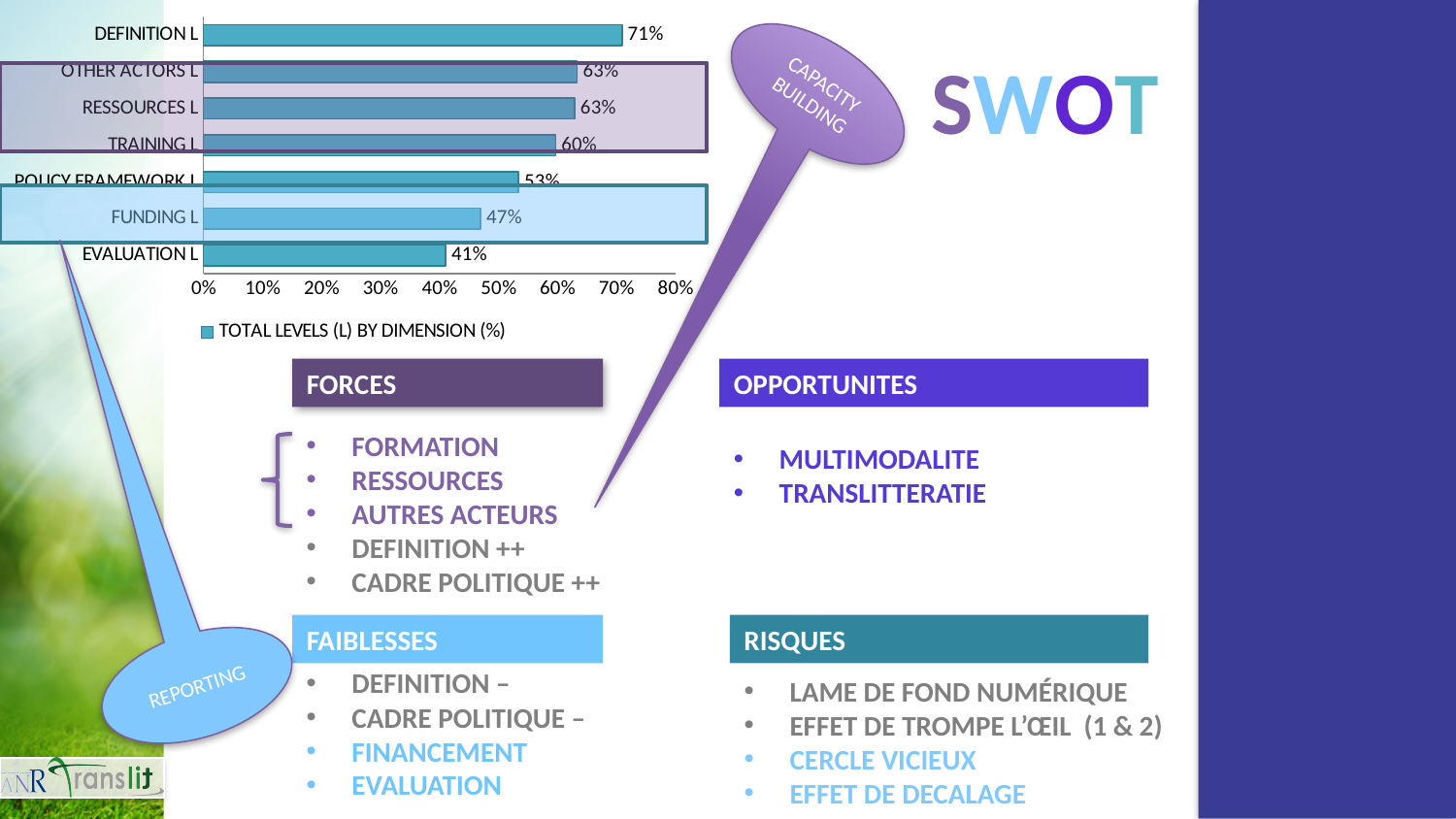
Which category has the lowest value? EVALUATION L Is the value for POLICY FRAMEWORK L greater or less than 60%? less What is the value for EVALUATION L? 41% Which is larger, the value for TRAINING L or the value for FUNDING L? TRAINING L How many categories are shown in the bar chart? 7 What is the legend entry of the chart? TOTAL LEVELS (L) BY DIMENSION (%) What is the value for FUNDING L? 47% What is the value for TRAINING L? 60% What is the difference between the values for DEFINITION L and EVALUATION L? 30% What is the value for DEFINITION L? 71% What kind of chart is shown on the slide? bar chart Which category has the highest value? DEFINITION L